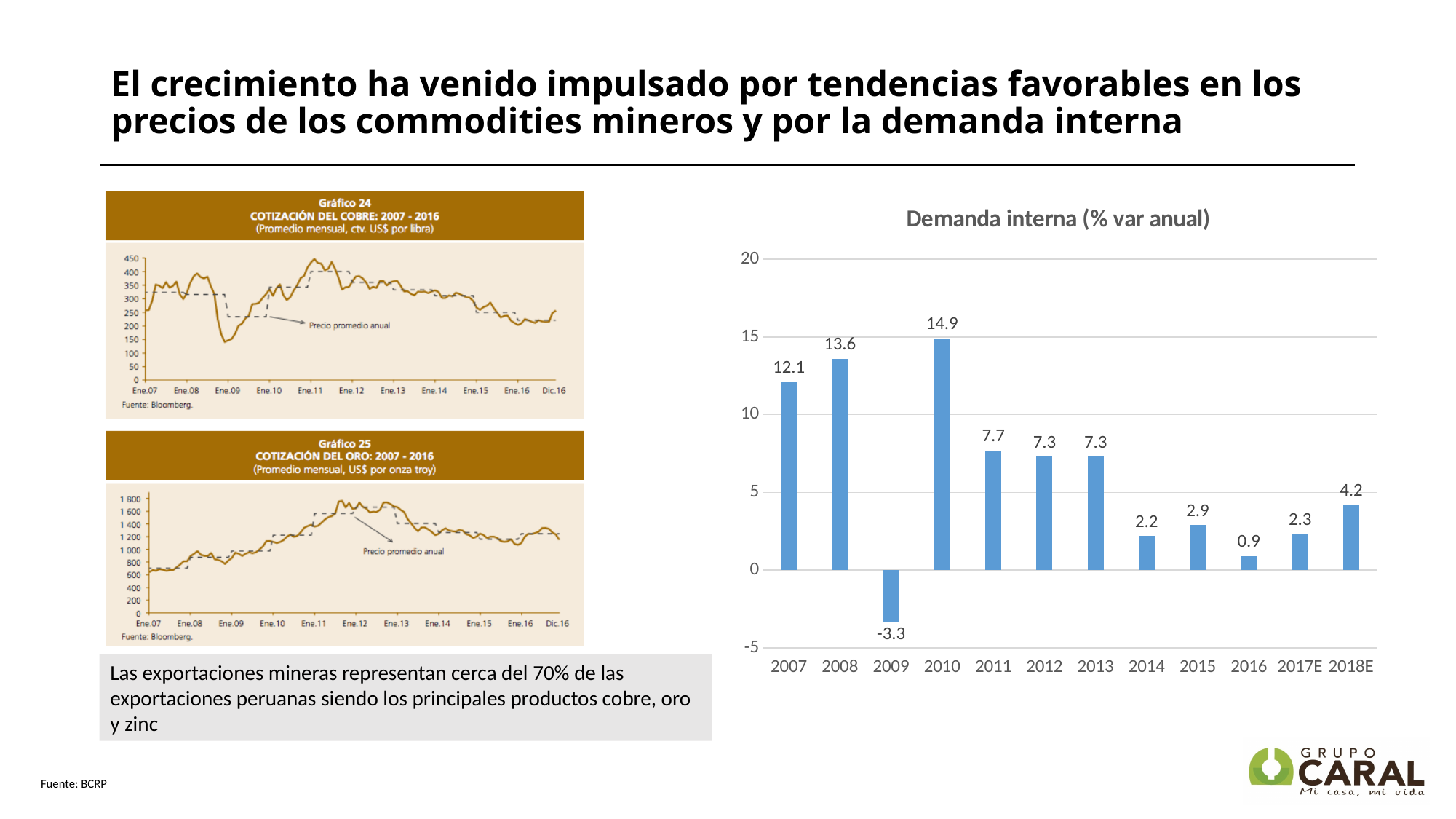
In the 'Demanda interna (% var anual)' chart, what is the difference between the values for 2018E and 2017E? 1.9 In the 'Demanda interna (% var anual)' chart, what is the value for 2018E? 4.2 In the 'Demanda interna (% var anual)' chart, which year has the highest value? 2010 In the 'Demanda interna (% var anual)' chart, do the values rise or fall from 2010 to 2016? fall What kind of chart is the 'Demanda interna (% var anual)' chart? bar chart In the 'Demanda interna (% var anual)' chart, what is the value for 2010? 14.9 In the 'Demanda interna (% var anual)' chart, what is the difference between the values for 2008 and 2007? 1.5 In the 'Demanda interna (% var anual)' chart, which year has the lowest value? 2009 In the 'Demanda interna (% var anual)' chart, which is larger, the value for 2014 or the value for 2015? 2015 How many years are shown on the x axis of the 'Demanda interna (% var anual)' chart? 12 What is the title of the bar chart on the right side of the slide? Demanda interna (% var anual) In the 'Gráfico 25 COTIZACIÓN DEL ORO' chart, is the gold price at Ene.07 greater or less than 1 000? less